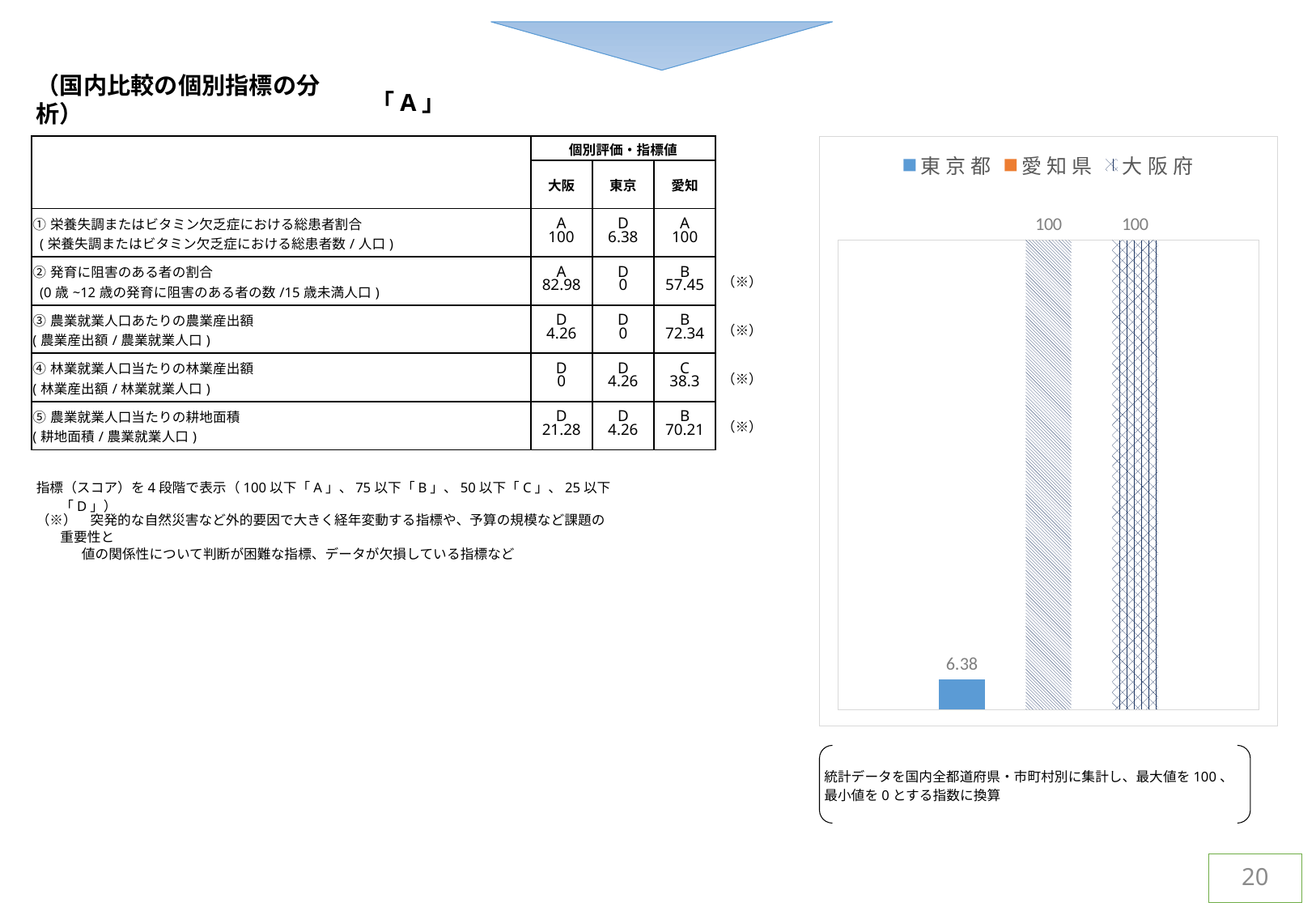
In the bar chart, how many bars are plotted? 3 In the bar chart, what is the value for 大阪府? 100 What kind of chart is shown on the right side of the slide? bar chart In the bar chart, what is the difference between the value for 愛知県 and the value for 東京都? 93.62 In the bar chart, which legend entry is shown in solid blue? 東京都 How many series does the legend of the bar chart list? 3 In the bar chart, do the values for 愛知県 and 大阪府 differ? No, both are 100 In the bar chart, which series has the lowest value? 東京都 In the bar chart, what is the value for 東京都? 6.38 In the bar chart, what is the value for 愛知県? 100 In the bar chart, which is larger, the value for 大阪府 or the value for 東京都? 大阪府